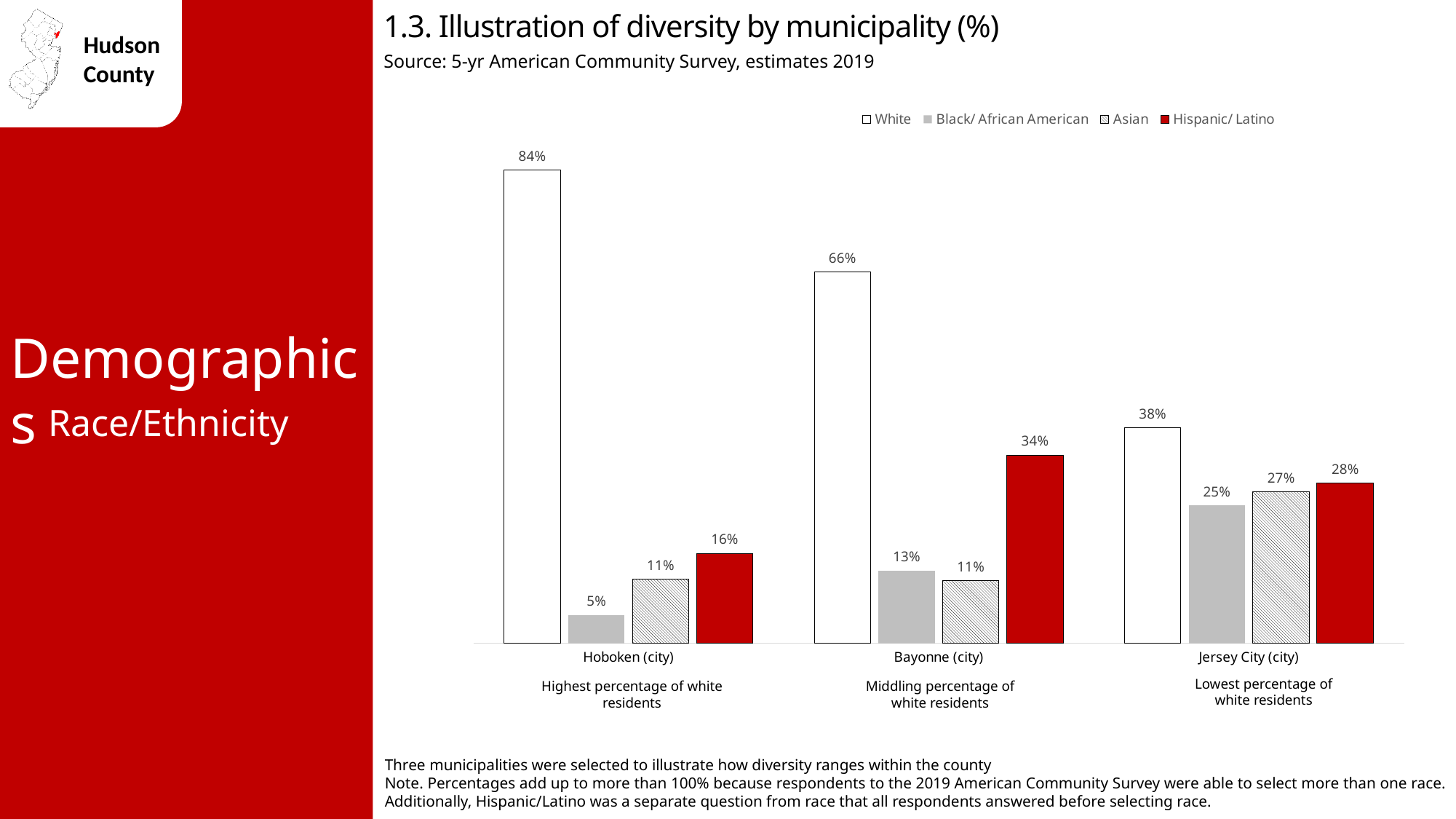
Which municipality has the lowest Black/ African American percentage? Hoboken (city) What is the difference between the White percentage in Hoboken (city) and in Jersey City (city)? 46% What is the Hispanic/ Latino percentage for Bayonne (city)? 34% What percentage of Hoboken (city) residents are White? 84% How many series does the legend list? 4 What is the Black/ African American percentage for Jersey City (city)? 25% Which municipality has the highest White percentage? Hoboken (city) Which series is shown in red on the chart? Hispanic/ Latino Which is larger: the Asian percentage in Jersey City (city) or the Hispanic/ Latino percentage in Bayonne (city)? Hispanic/ Latino percentage in Bayonne (city) How many municipalities are shown on the chart? 3 What is the Asian percentage for Hoboken (city)? 11% What kind of chart is shown on the slide? Bar chart